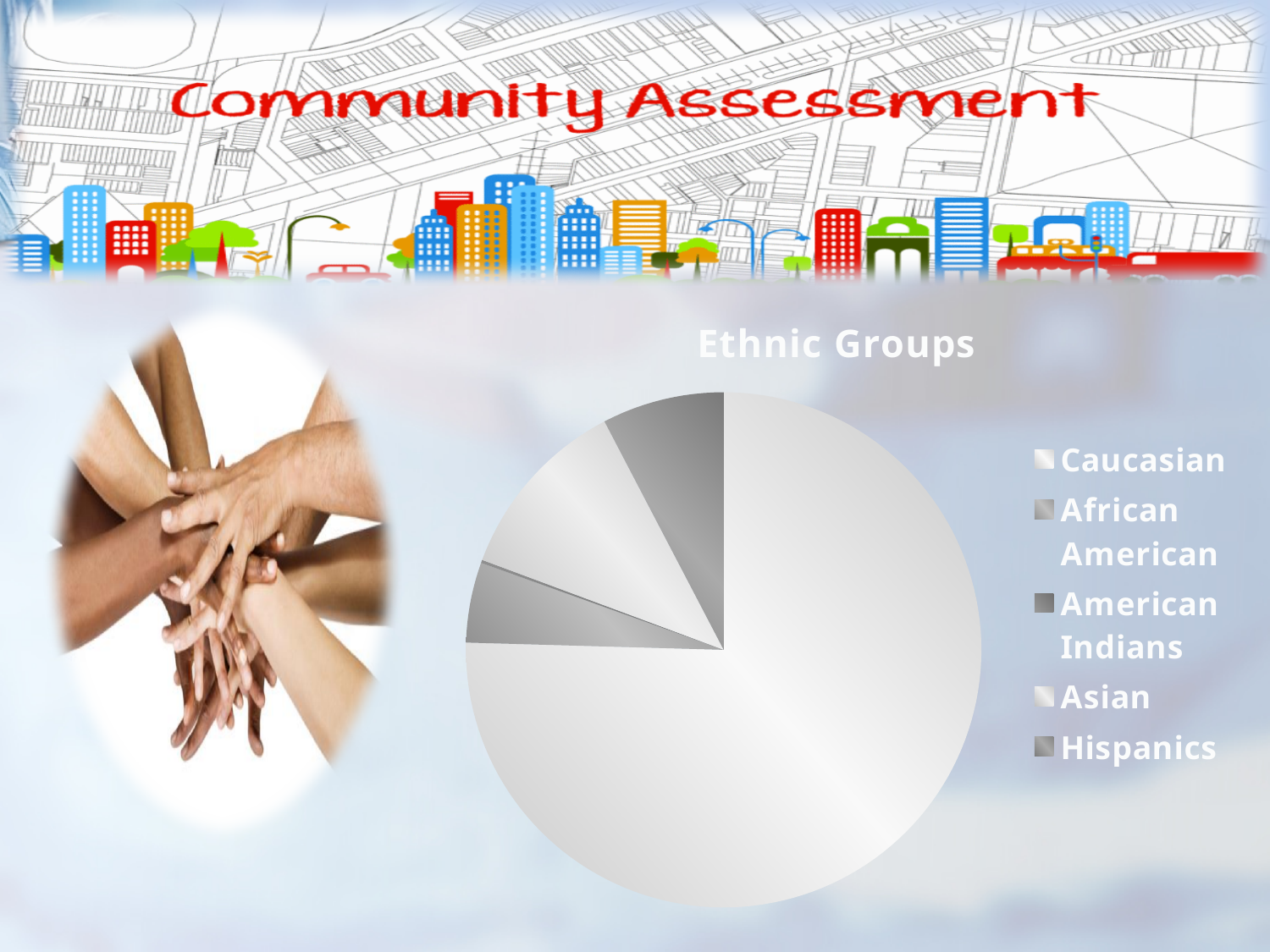
How many ethnic groups (categories) does the pie chart show? 5 Which ethnic group is listed first in the legend? Caucasian Which ethnic group has the largest slice of the pie? Caucasian Which is larger, the slice for Caucasian or the slice for Asian? Caucasian What is the title of the chart? Ethnic Groups What kind of chart is shown on the slide? Pie chart How many data series does the pie chart plot? 1 Which is larger, the slice for American Indians or the slice for Caucasian? Caucasian Which is larger, the slice for Caucasian or the slice for Hispanics? Caucasian